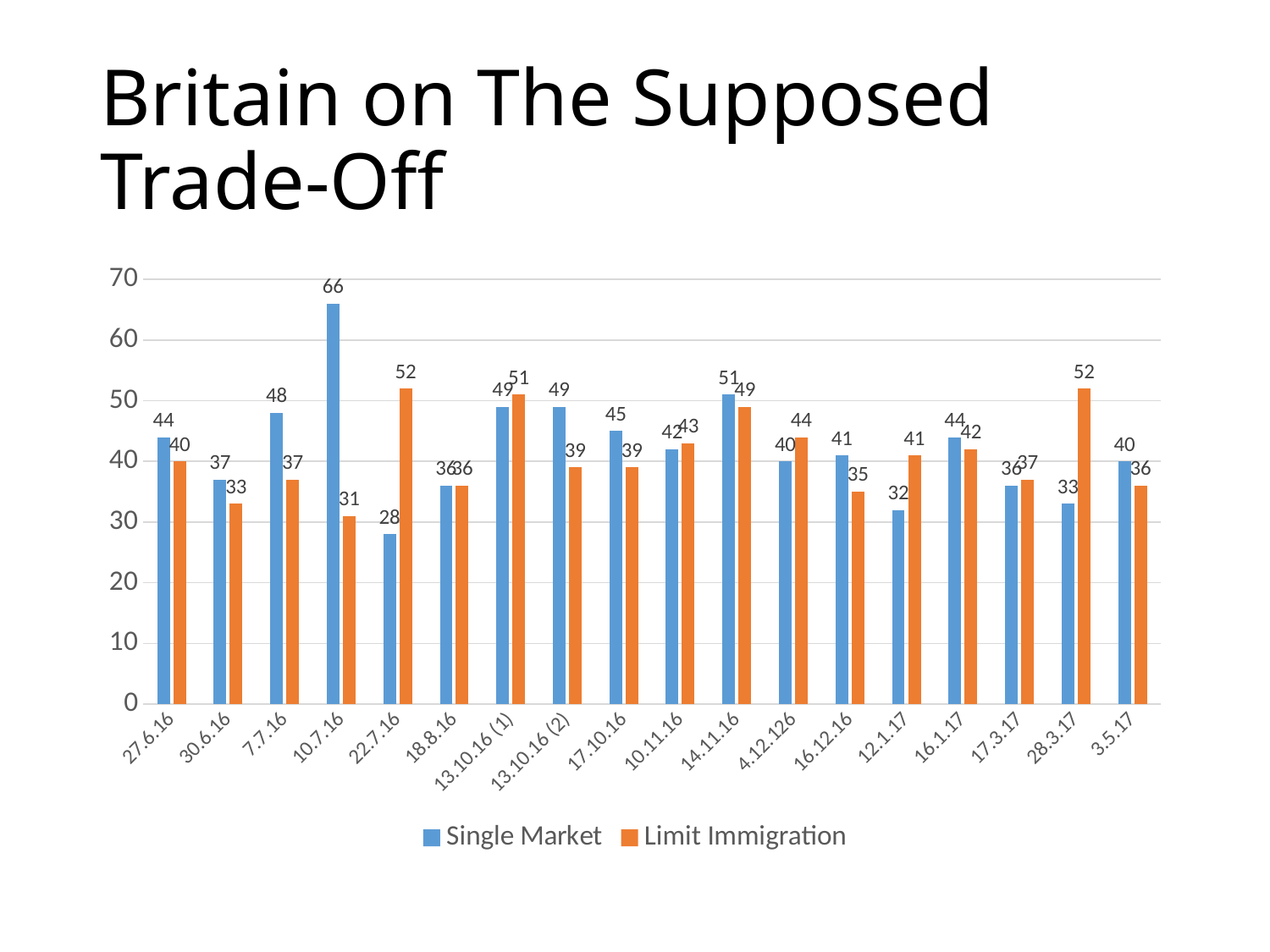
What kind of chart is shown on the slide? Bar chart What is the Single Market value for 12.1.17? 32 Which date has the lowest Single Market value? 22.7.16 How many series does the legend list? 2 What is the Limit Immigration value for 16.12.16? 35 What is the difference between the Single Market and Limit Immigration values for 10.7.16? 35 How many dates are shown on the x axis? 18 Which date has the highest Single Market value? 10.7.16 What is the Limit Immigration value for 22.7.16? 52 Which date has the lowest Limit Immigration value? 10.7.16 What is the Single Market value for 10.7.16? 66 For 28.3.17, which is larger: Single Market or Limit Immigration? Limit Immigration